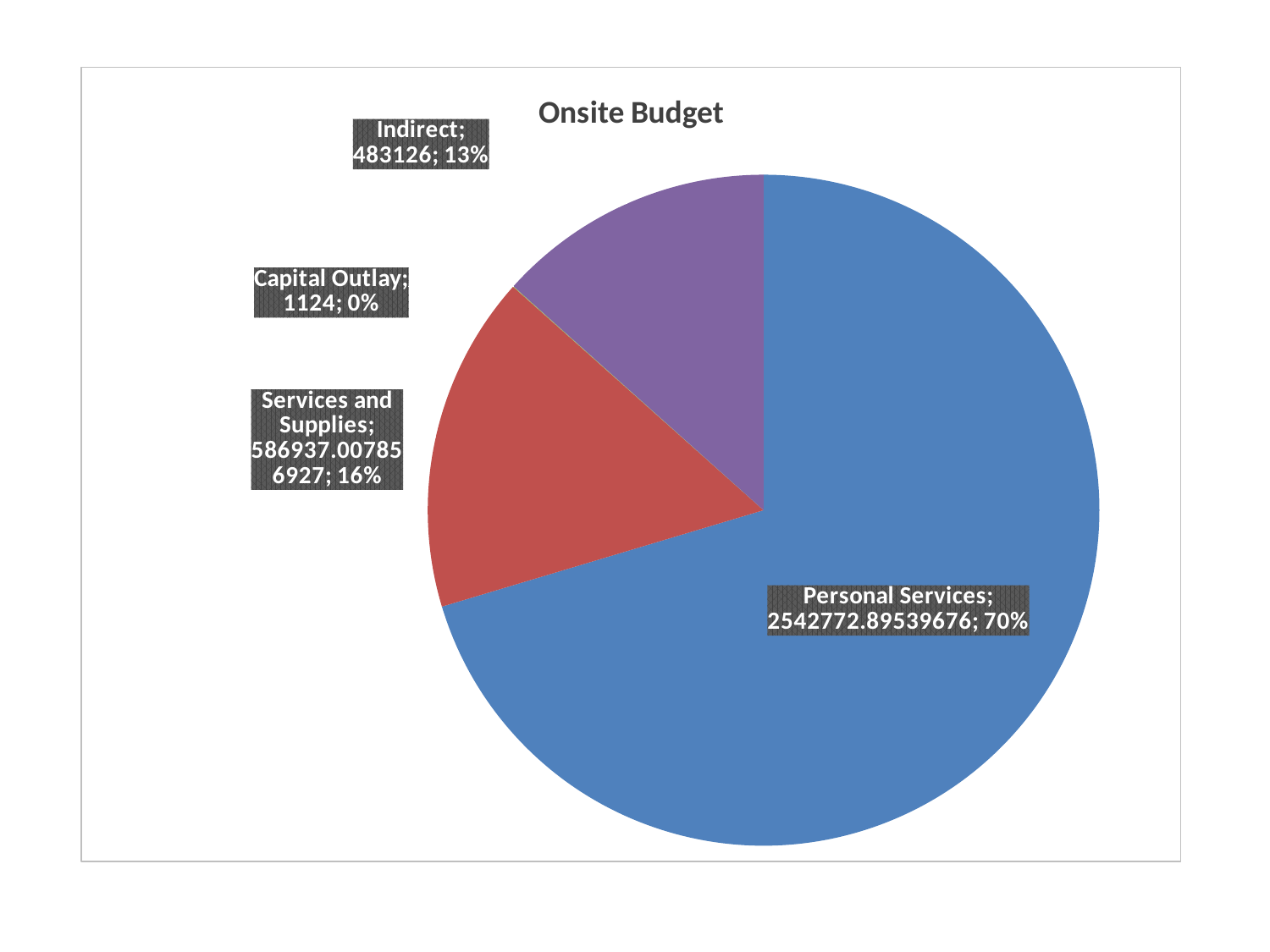
What is the value for Indirect? 483126 Which category has the smallest slice? Capital Outlay What is the value for Capital Outlay? 1124 What type of chart is shown on the slide? Pie chart Which category has the largest slice? Personal Services What is the difference between the values for Indirect and Capital Outlay? 482002 What share of the pie does Personal Services represent? 70% What is the title of the chart? Onsite Budget What share of the pie does Services and Supplies represent? 16% How many slices does the pie chart have? 4 Which is larger, Services and Supplies or Indirect? Services and Supplies What is the value for Personal Services? 2542772.89539676